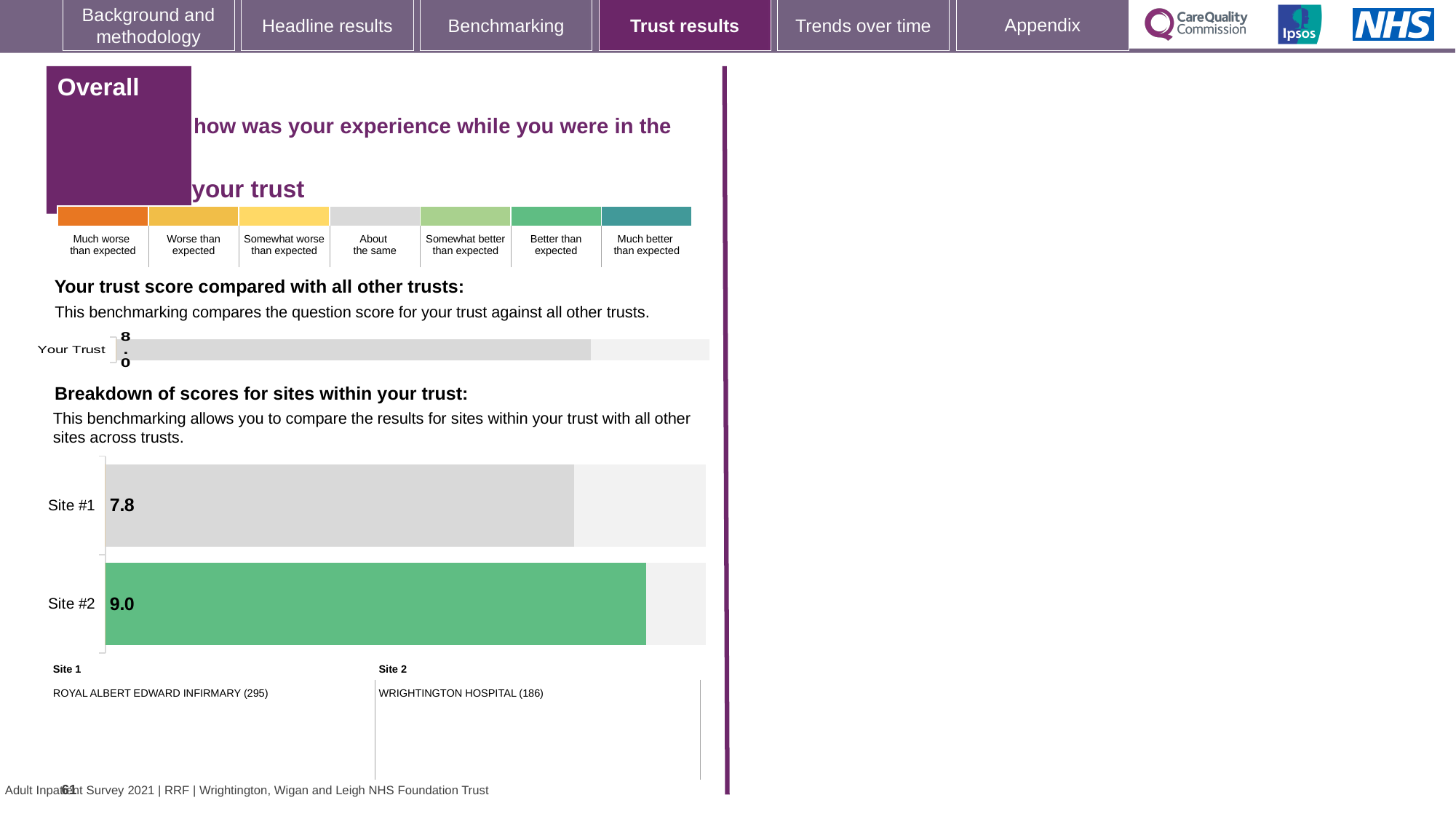
In the 'Breakdown of scores for sites within your trust' chart, what is the score for Site #2? 9.0 In the 'Breakdown of scores for sites within your trust' chart, what is the score for Site #1? 7.8 What kind of chart is the 'Breakdown of scores for sites within your trust' chart? Bar chart In the 'Your trust score compared with all other trusts' chart, what is the score for Your Trust? 8.0 In the 'Breakdown of scores for sites within your trust' chart, which site has the lowest score? Site #1 How many sites are shown in the 'Breakdown of scores for sites within your trust' chart? 2 In the 'Breakdown of scores for sites within your trust' chart, what is the difference between the scores of Site #2 and Site #1? 1.2 According to the site key below the chart, which hospital is Site 2? WRIGHTINGTON HOSPITAL (186) Is the score for Site #1 in the 'Breakdown of scores for sites within your trust' chart greater or less than the score for Your Trust in the chart above? less In the 'Breakdown of scores for sites within your trust' chart, which site has the highest score? Site #2 In the 'Breakdown of scores for sites within your trust' chart, which site's bar is coloured green? Site #2 In the 'Breakdown of scores for sites within your trust' chart, which is larger, the score for Site #1 or Site #2? Site #2